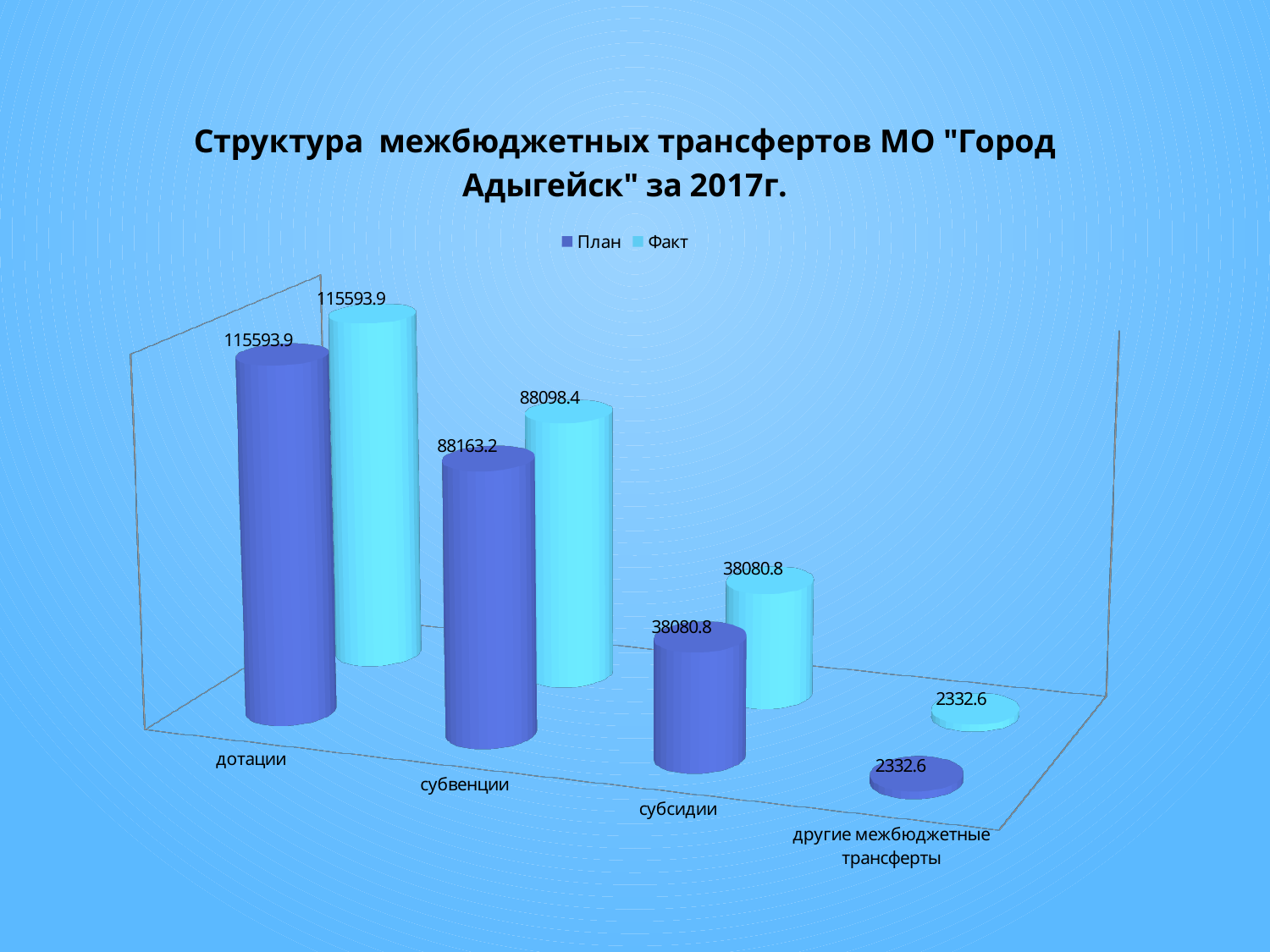
Do the Факт values rise or fall from дотации to другие межбюджетные трансферты? fall What is the Факт value for другие межбюджетные трансферты? 2332.6 What is the План value for дотации? 115593.9 Which is larger for субвенции, the План value or the Факт value? План How many series does the legend list? 2 What is the difference between the План and Факт values for субвенции? 64.8 What kind of chart is shown on the slide? bar chart What is the План value for субсидии? 38080.8 How many categories are shown on the x axis? 4 What is the Факт value for субвенции? 88098.4 Which category has the lowest Факт value? другие межбюджетные трансферты Which category has the highest План value? дотации